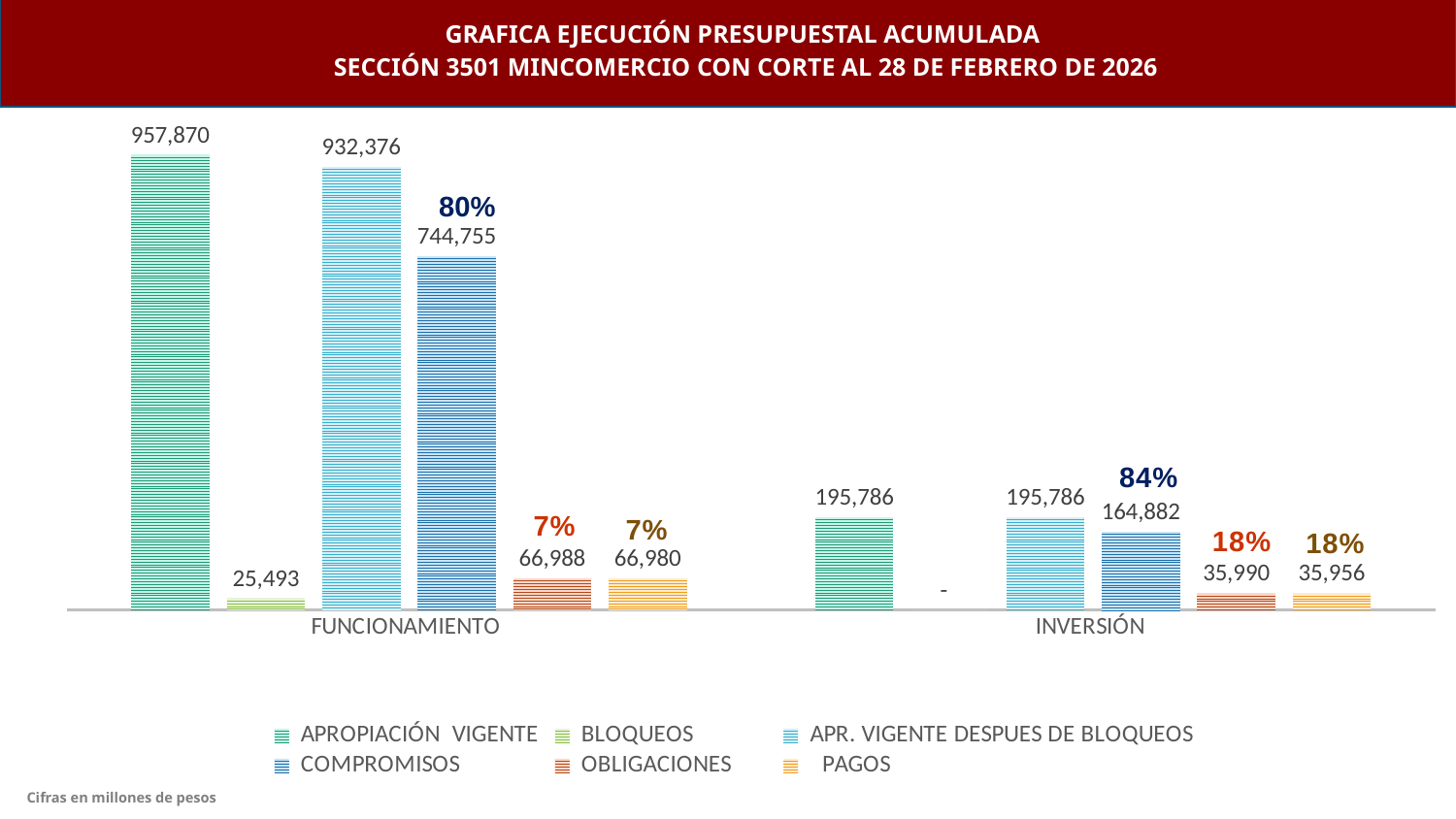
What is the difference between APROPIACIÓN VIGENTE and APR. VIGENTE DESPUES DE BLOQUEOS for FUNCIONAMIENTO? 25,494 What is the BLOQUEOS value for FUNCIONAMIENTO? 25,493 What kind of chart is shown on the slide? Bar chart Which series has the lowest value in the FUNCIONAMIENTO group? BLOQUEOS What percentage is shown above the COMPROMISOS bar for FUNCIONAMIENTO? 80% What is the APROPIACIÓN VIGENTE value for FUNCIONAMIENTO? 957,870 What percentage is shown above the OBLIGACIONES bar for INVERSIÓN? 18% What is the COMPROMISOS value for INVERSIÓN? 164,882 How many categories are shown on the x axis? 2 Which series has the highest value in the INVERSIÓN group? APROPIACIÓN VIGENTE and APR. VIGENTE DESPUES DE BLOQUEOS (both 195,786) Which is larger: COMPROMISOS for FUNCIONAMIENTO or COMPROMISOS for INVERSIÓN? FUNCIONAMIENTO How many series does the legend list? 6